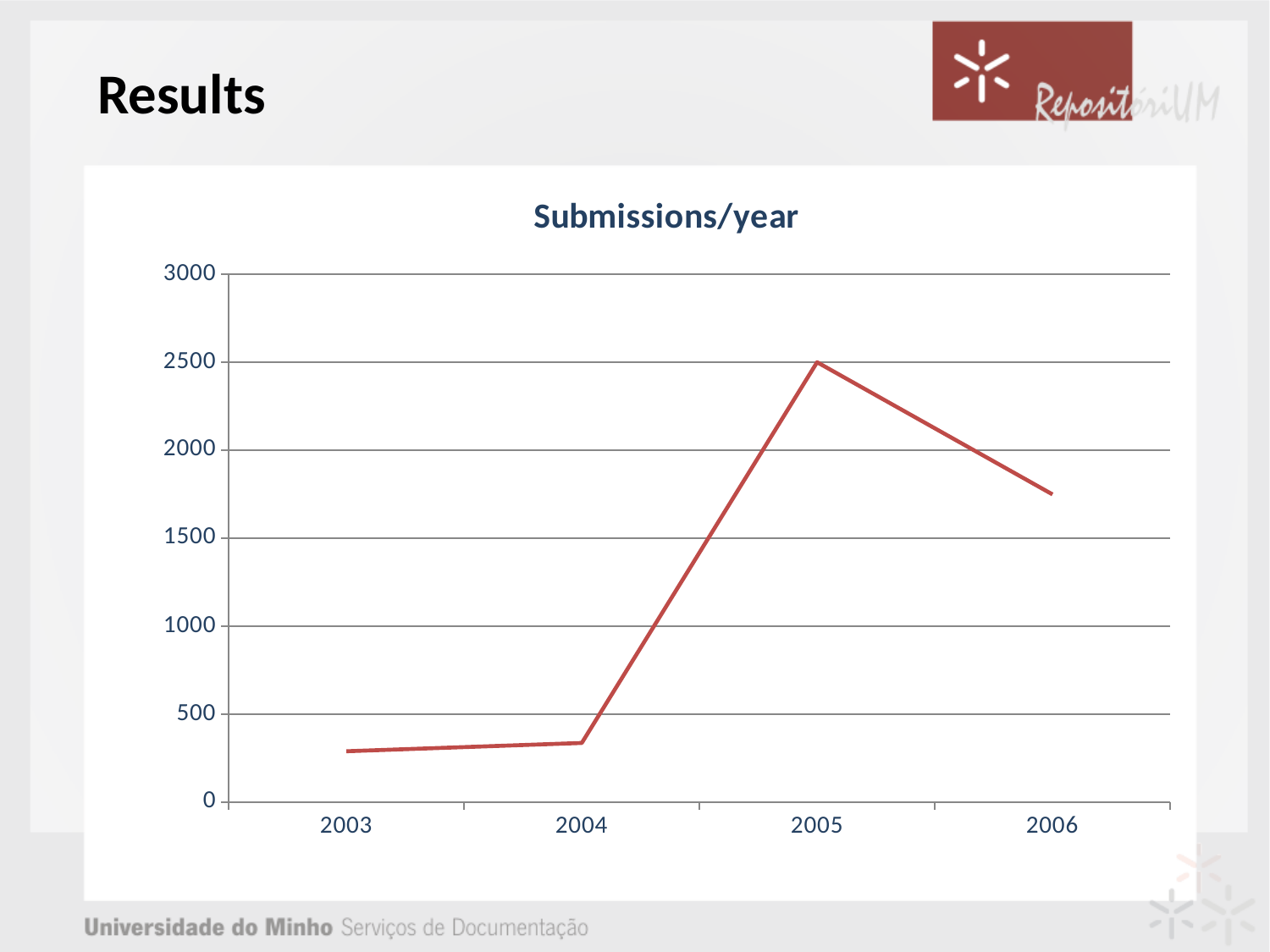
What is the title of the chart? Submissions/year How many years are plotted on the x axis? 4 Which year has the lowest number of submissions? 2003 Which year has more submissions, 2005 or 2006? 2005 Is the value for 2004 greater or less than 500? less Is the value for 2006 greater or less than 2000? less Does the line rise or fall between 2005 and 2006? fall Is the value for 2005 greater or less than 2000? greater Which year has the highest number of submissions? 2005 What kind of chart is shown on the slide? line chart